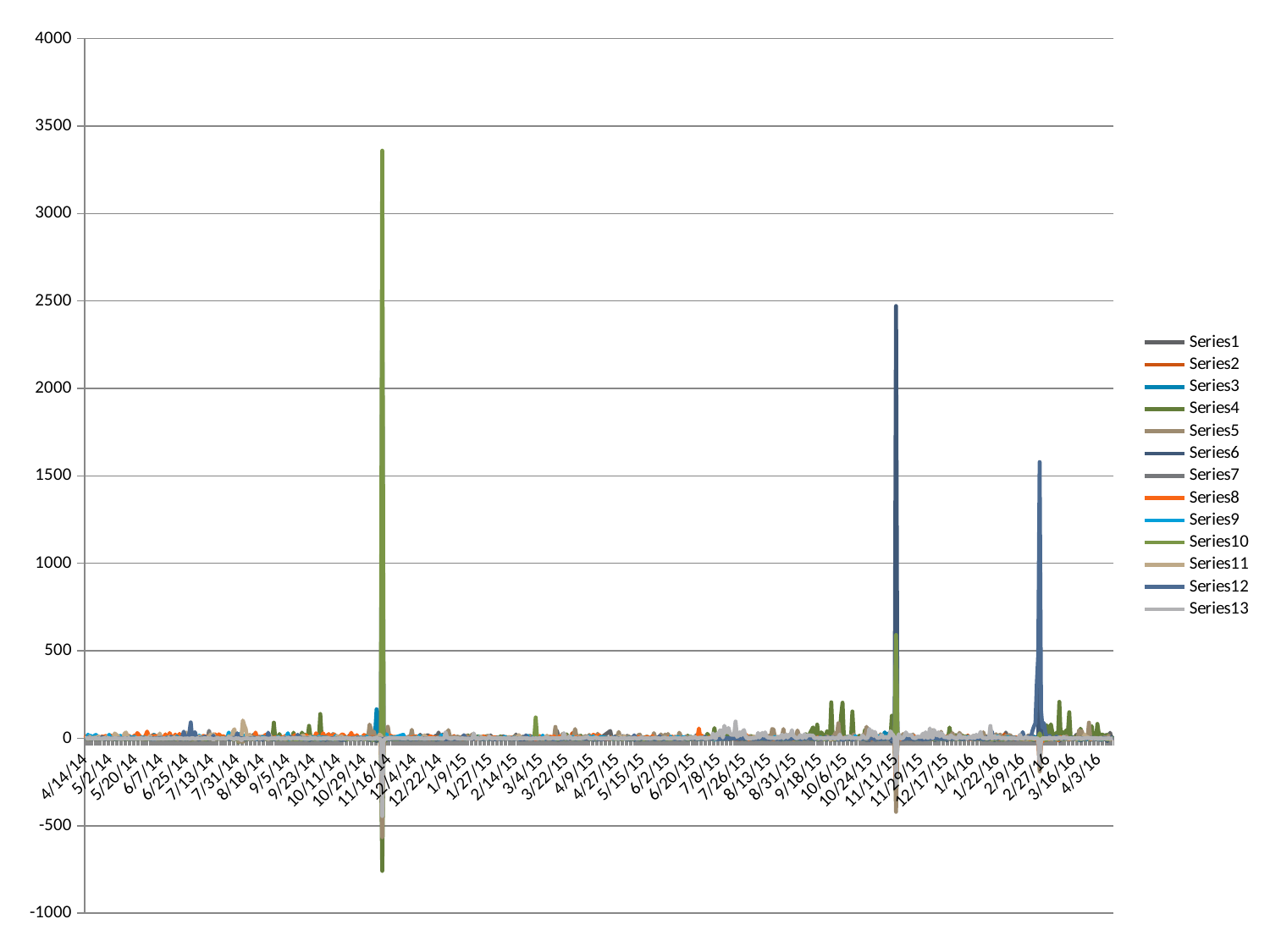
Is the lowest dip on the chart, near 11/16/14, greater or less than -500? less What is the first date label on the horizontal axis? 4/14/14 What kind of chart is shown on the slide? line chart Is the spike near 11/11/15 greater or less than 3000? less How many series does the legend list? 13 What is the highest value shown on the vertical axis? 4000 Is the spike near 2/27/16 greater or less than 1000? greater